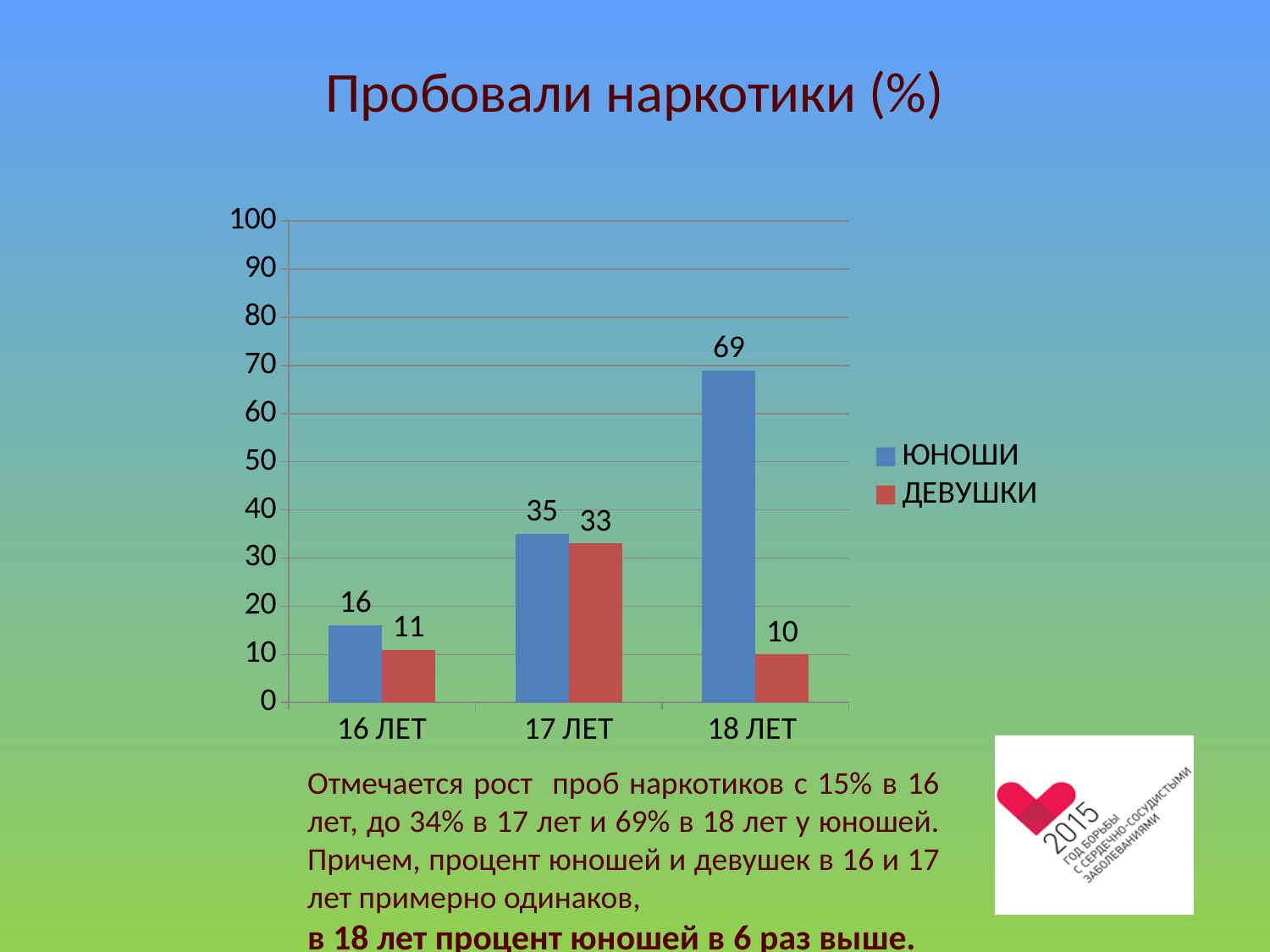
What is the title of the chart? Пробовали наркотики (%) What is the value for ДЕВУШКИ at 17 ЛЕТ? 33 Which is larger at 17 ЛЕТ, ЮНОШИ or ДЕВУШКИ? ЮНОШИ What is the difference between ЮНОШИ and ДЕВУШКИ at 18 ЛЕТ? 59 How many series does the legend list? 2 Which age group has the lowest value for ДЕВУШКИ? 18 ЛЕТ Which age group has the highest value for ЮНОШИ? 18 ЛЕТ What is the value for ДЕВУШКИ at 16 ЛЕТ? 11 Do the values for ЮНОШИ rise or fall from 16 ЛЕТ to 18 ЛЕТ? rise What is the value for ЮНОШИ at 18 ЛЕТ? 69 How many age categories are shown on the x axis? 3 What kind of chart is shown on the slide? bar chart